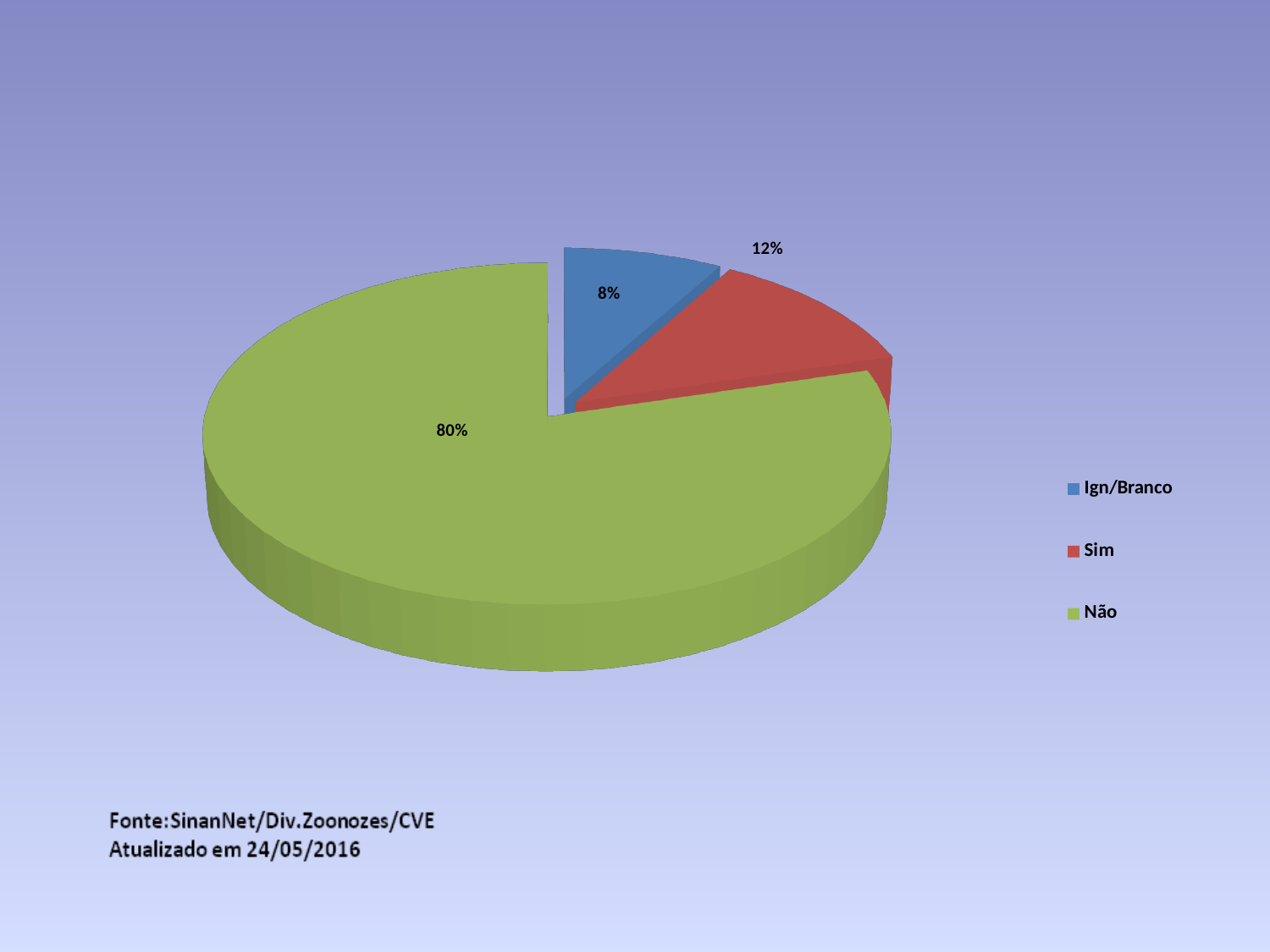
What colour is the Não slice in the pie chart? green Which slice is larger, Sim or Ign/Branco? Sim Which category has the largest slice of the pie? Não How many entries does the legend list? 3 What share of the pie does the Ign/Branco slice represent? 8% How many slices does the pie chart have? 3 What share of the pie does the Sim slice represent? 12% What kind of chart is shown on the slide? pie chart What share of the pie does the Não slice represent? 80% Which category has the smallest slice of the pie? Ign/Branco What is the difference in percentage points between the Sim slice and the Ign/Branco slice? 4 What is the difference in percentage points between the Não slice and the Sim slice? 68